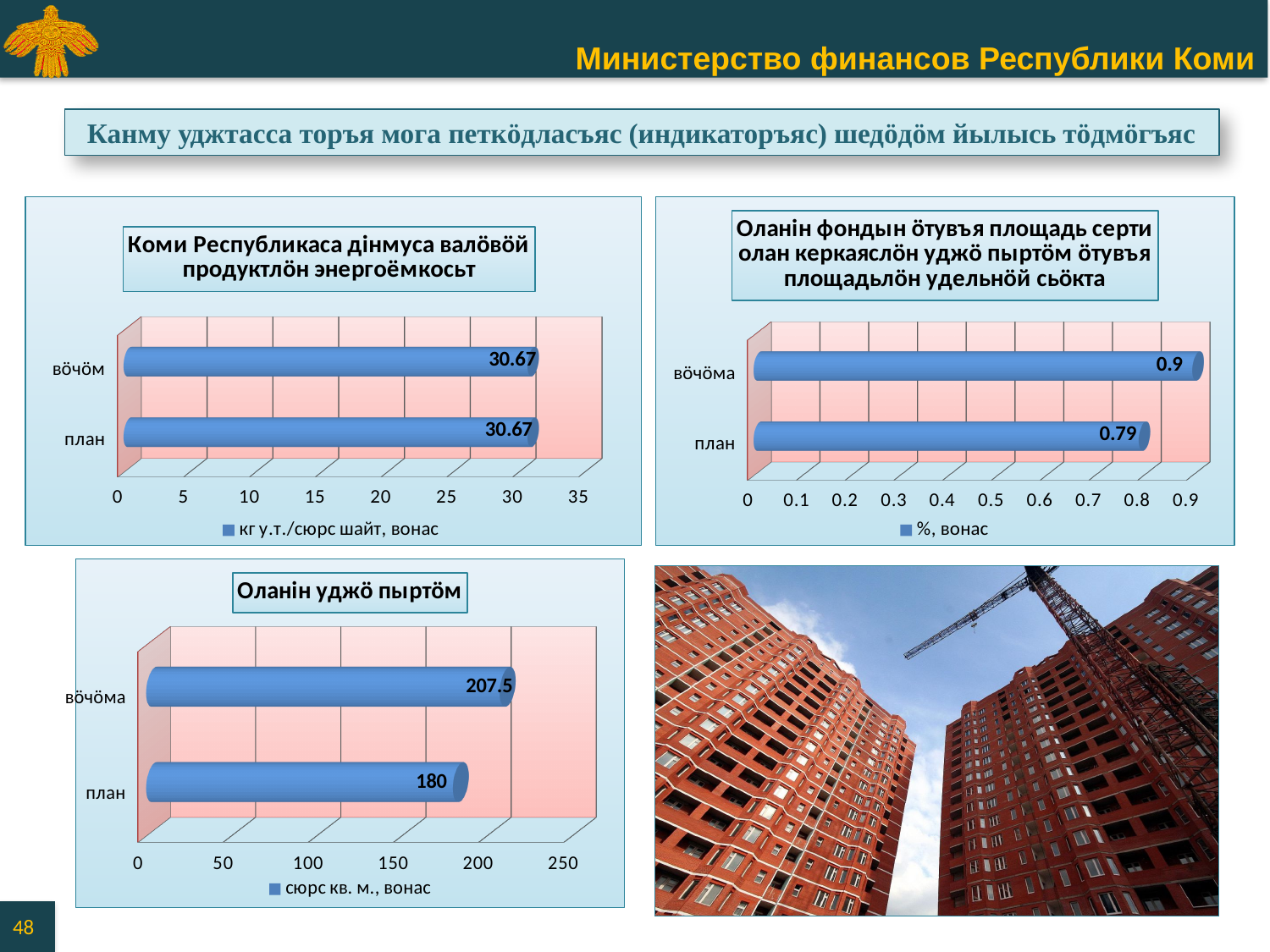
In the top-left chart, what is the difference between the вӧчӧм and план values? 0 In the bottom-left chart (Оланін уджӧ пыртӧм), what is the value for план? 180 In the top-right chart, which category has the higher value, вӧчӧма or план? вӧчӧма What type of chart is the bottom-left chart (Оланін уджӧ пыртӧм)? bar chart In the top-left chart (Коми Республикаса дінмуса валӧвӧй продуктлӧн энергоёмкосьт), what is the value for вӧчӧм? 30.67 In the top-left chart (Коми Республикаса дінмуса валӧвӧй продуктлӧн энергоёмкосьт), what is the value for план? 30.67 In the top-right chart (Оланін фондын ӧтувъя площадь серти ...), what is the value for план? 0.79 In the top-right chart (Оланін фондын ӧтувъя площадь серти ...), what is the value for вӧчӧма? 0.9 In the bottom-left chart (Оланін уджӧ пыртӧм), which category has the lowest value? план What is the legend entry of the bottom-left chart (Оланін уджӧ пыртӧм)? сюрс кв. м., вонас In the bottom-left chart (Оланін уджӧ пыртӧм), what is the difference between the вӧчӧма and план values? 27.5 In the bottom-left chart (Оланін уджӧ пыртӧм), what is the value for вӧчӧма? 207.5